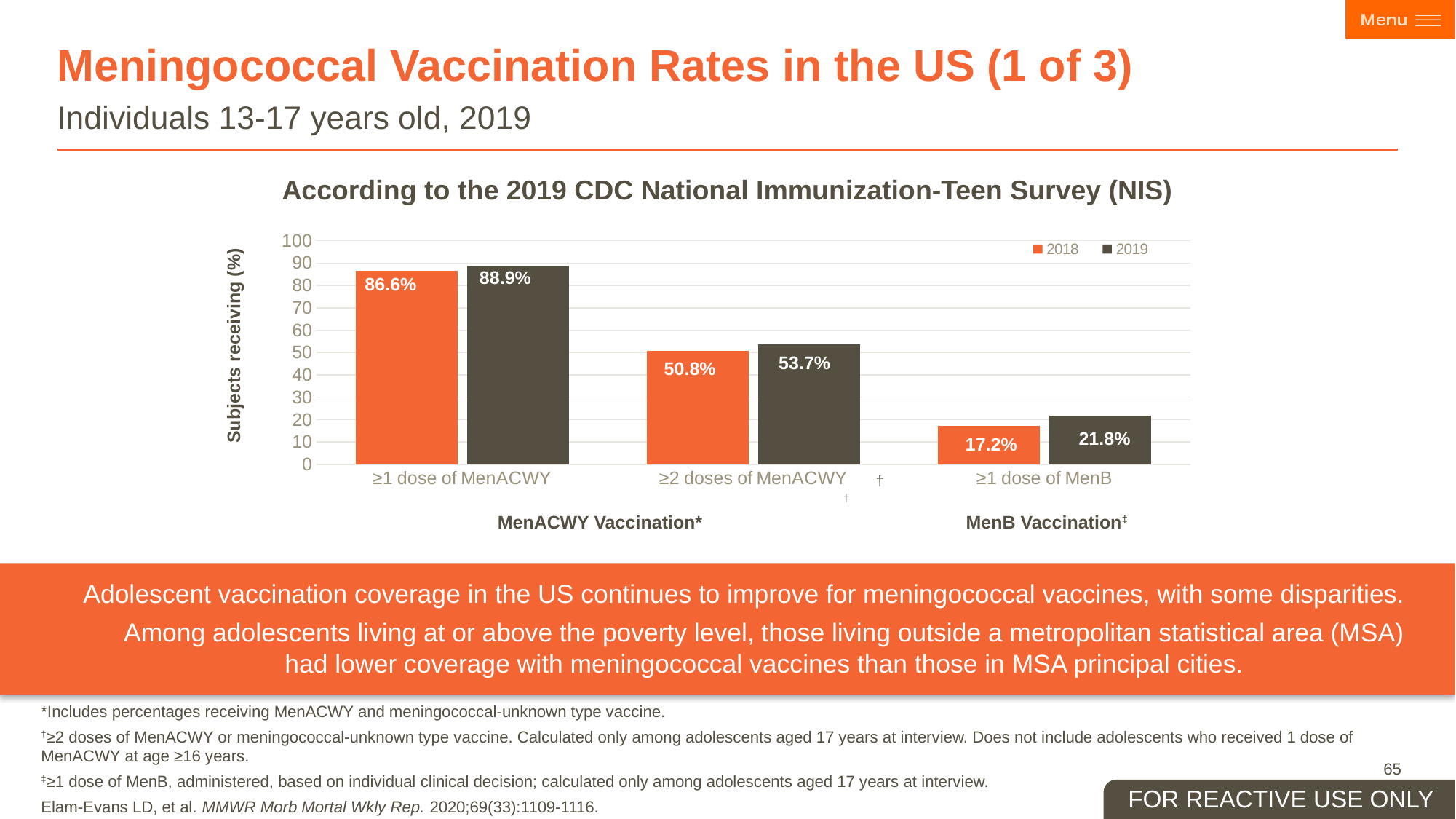
What was the percentage of subjects receiving ≥2 doses of MenACWY in 2018? 50.8% What is the difference between the 2019 and 2018 values for ≥1 dose of MenB? 4.6% How many series does the legend list? 2 Which is larger for ≥1 dose of MenACWY, the 2018 value or the 2019 value? 2019 How many vaccination categories are shown on the x axis? 3 Which category had the highest value in 2018? ≥1 dose of MenACWY Which category had the lowest value in 2019? ≥1 dose of MenB What was the percentage of subjects receiving ≥1 dose of MenB in 2019? 21.8% What is the label of the y axis? Subjects receiving (%) What is the difference between the 2019 and 2018 values for ≥2 doses of MenACWY? 2.9% What was the percentage of subjects receiving ≥1 dose of MenACWY in 2019? 88.9% What kind of chart is shown on the slide? Bar chart